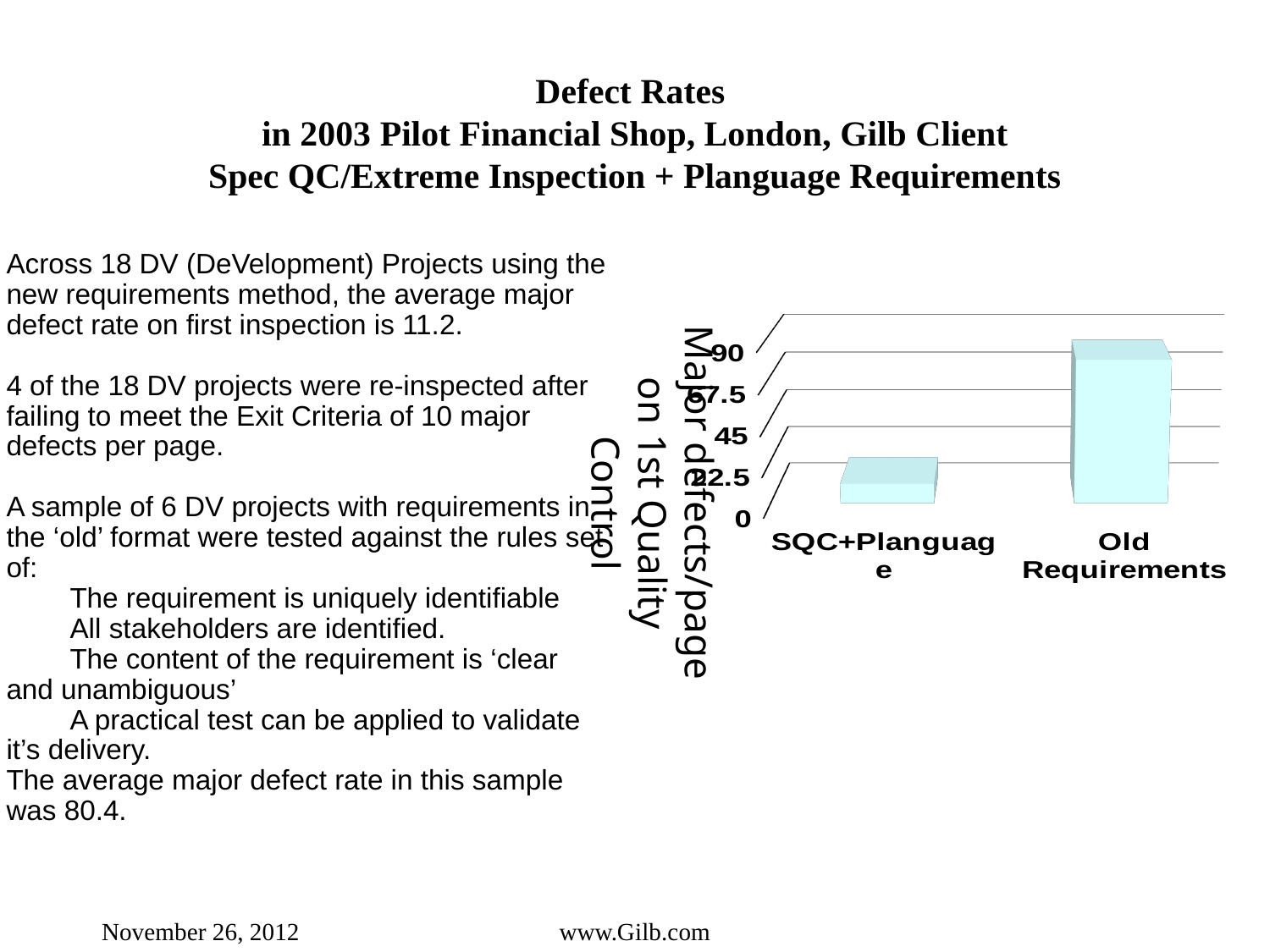
Which is larger, the bar for SQC+Planguage or the bar for Old Requirements? Old Requirements Which category has the lowest bar in the chart? SQC+Planguage What is the title of the vertical axis of the chart? Major defects/page on 1st Quality Control Which category has the highest bar in the chart? Old Requirements What is the highest tick value shown on the vertical axis of the chart? 90 Is the value for SQC+Planguage greater or less than 22.5? less How many categories are plotted on the x axis of the chart? 2 Is the value for SQC+Planguage greater or less than 45? less Is the value for Old Requirements greater or less than 67.5? greater What kind of chart is shown on the slide? bar chart